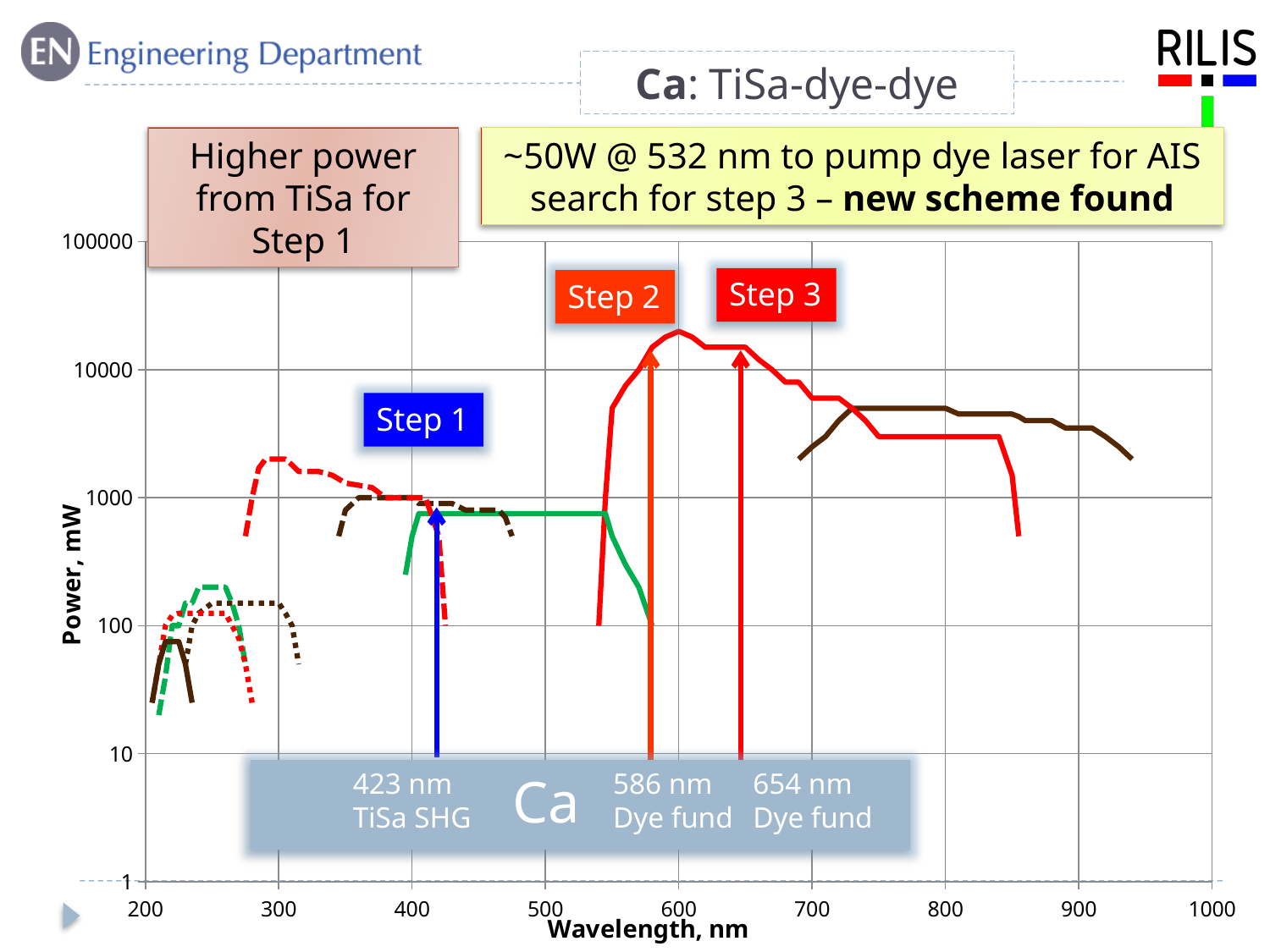
At what wavelength is the Step 3 arrow placed on the chart? 654 nm At what wavelength is the Step 1 arrow placed on the chart? 423 nm Is the power of the solid green curve at the Step 1 wavelength (423 nm) greater or less than 1000 mW? less Which laser source is labelled for the 423 nm step? TiSa SHG At what wavelength is the Step 2 arrow placed on the chart? 586 nm What is the label of the y axis of the chart? Power, mW Which is higher on the chart: the power at the Step 2 arrow (586 nm) or the power at the Step 1 arrow (423 nm)? Step 2 (586 nm) Is the power of the solid red curve at the Step 2 wavelength (586 nm) greater or less than 10000 mW? greater Does the solid red curve rise or fall as wavelength increases from 600 nm to 850 nm? fall What kind of chart is shown on the slide? line chart What is the highest value shown on the x axis of the chart? 1000 What is the label of the x axis of the chart? Wavelength, nm